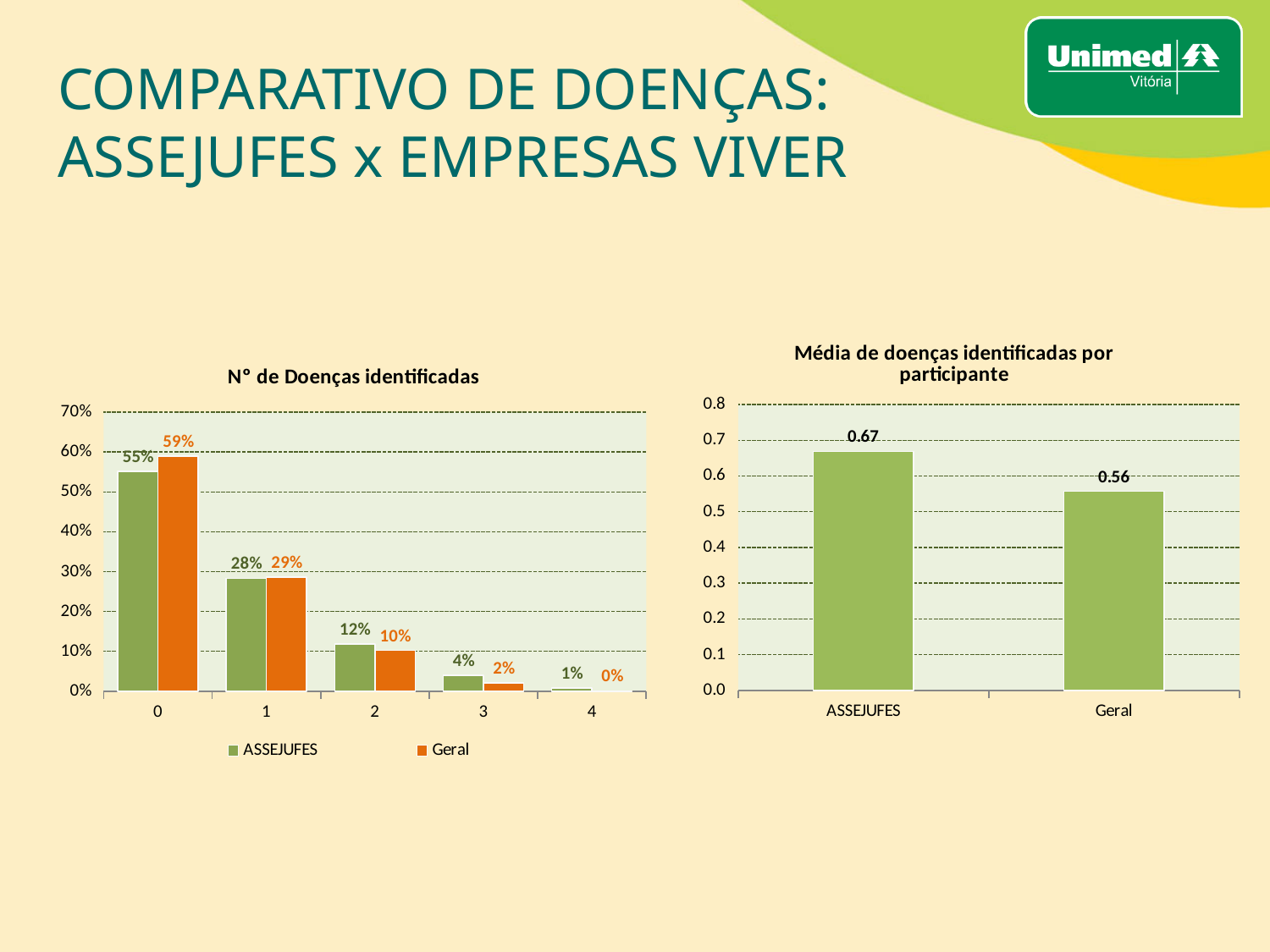
In the 'N° de Doenças identificadas' chart, how many categories are shown on the x axis? 5 In the 'Média de doenças identificadas por participante' chart, what is the value for ASSEJUFES? 0.67 In the 'N° de Doenças identificadas' chart, what is the ASSEJUFES value for category 0? 55% In the 'N° de Doenças identificadas' chart, what is the Geral value for category 2? 10% In the 'N° de Doenças identificadas' chart, which is larger for category 3: ASSEJUFES or Geral? ASSEJUFES In the 'N° de Doenças identificadas' chart, do the ASSEJUFES values rise or fall from category 0 to category 4? fall In the 'Média de doenças identificadas por participante' chart, which category has the lowest value? Geral In the 'N° de Doenças identificadas' chart, which category has the highest Geral value? 0 In the 'N° de Doenças identificadas' chart, what is the difference between the Geral and ASSEJUFES values for category 0? 4% In the 'Média de doenças identificadas por participante' chart, what is the difference between ASSEJUFES and Geral? 0.11 What kind of chart is the 'Média de doenças identificadas por participante' chart? bar chart In the 'N° de Doenças identificadas' chart, how many series does the legend list? 2